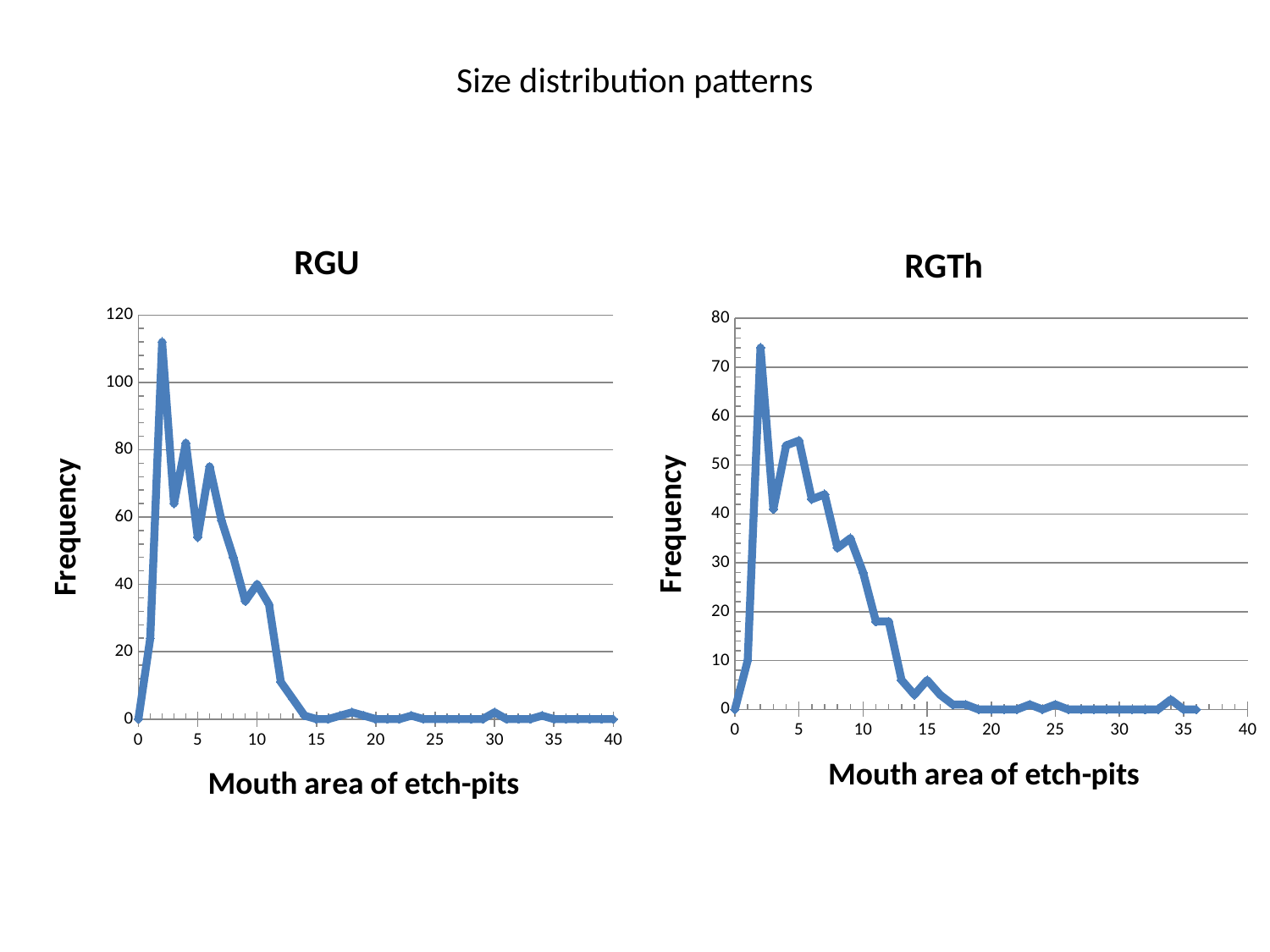
In the RGTh chart, is the value at a mouth area of 5 greater or less than 40? greater In the RGU chart, is the value at a mouth area of 20 greater or less than 20? less What is the label on the x axis of the RGTh chart? Mouth area of etch-pits What kind of chart is the RGU chart? line chart In the RGTh chart, is the peak value greater or less than 70? greater Which chart has the higher peak frequency, RGU or RGTh? RGU In the RGTh chart, do the values rise or fall as mouth area increases from 5 to 20? fall What is the label on the y axis of the RGU chart? Frequency What kind of chart is the RGTh chart? line chart